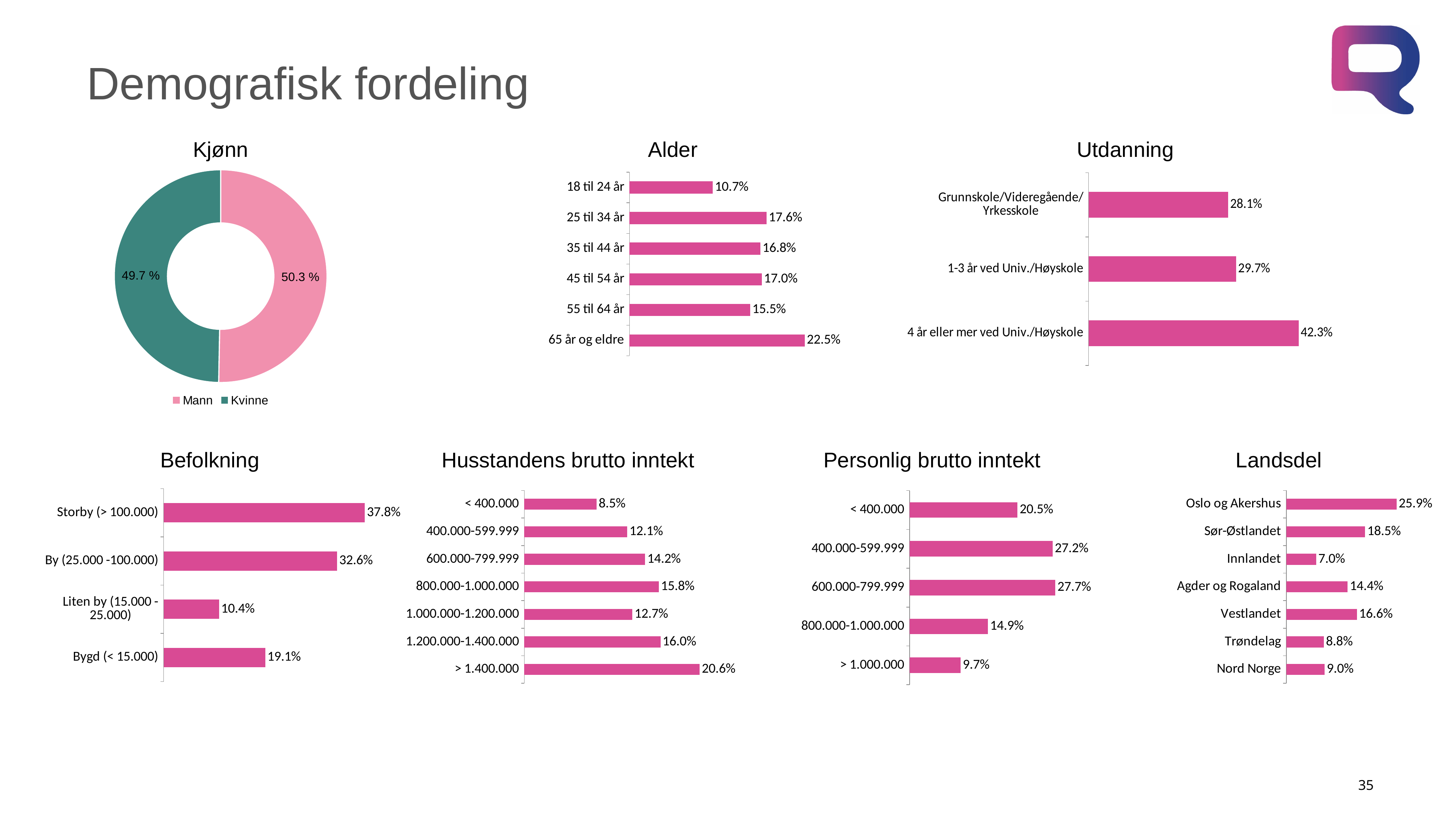
In the Utdanning chart, which category has the highest value? 4 år eller mer ved Univ./Høyskole In the Husstandens brutto inntekt chart, which income bracket has the highest value? > 1.400.000 In the Landsdel chart, what is the value for Vestlandet? 16.6% How many categories does the Befolkning chart show? 4 What kind of chart is the Kjønn chart? Doughnut chart How many categories does the Landsdel chart show? 7 In the Utdanning chart, what is the difference between 4 år eller mer ved Univ./Høyskole and Grunnskole/Videregående/Yrkesskole? 14.2% In the Alder chart, what is the value for 65 år og eldre? 22.5% In the Befolkning chart, what is the value for Bygd (< 15.000)? 19.1% In the Alder chart, which age group has the lowest value? 18 til 24 år In the Kjønn chart, what share is shown for Mann? 50.3 % In the Personlig brutto inntekt chart, which is larger: 400.000-599.999 or 800.000-1.000.000? 400.000-599.999